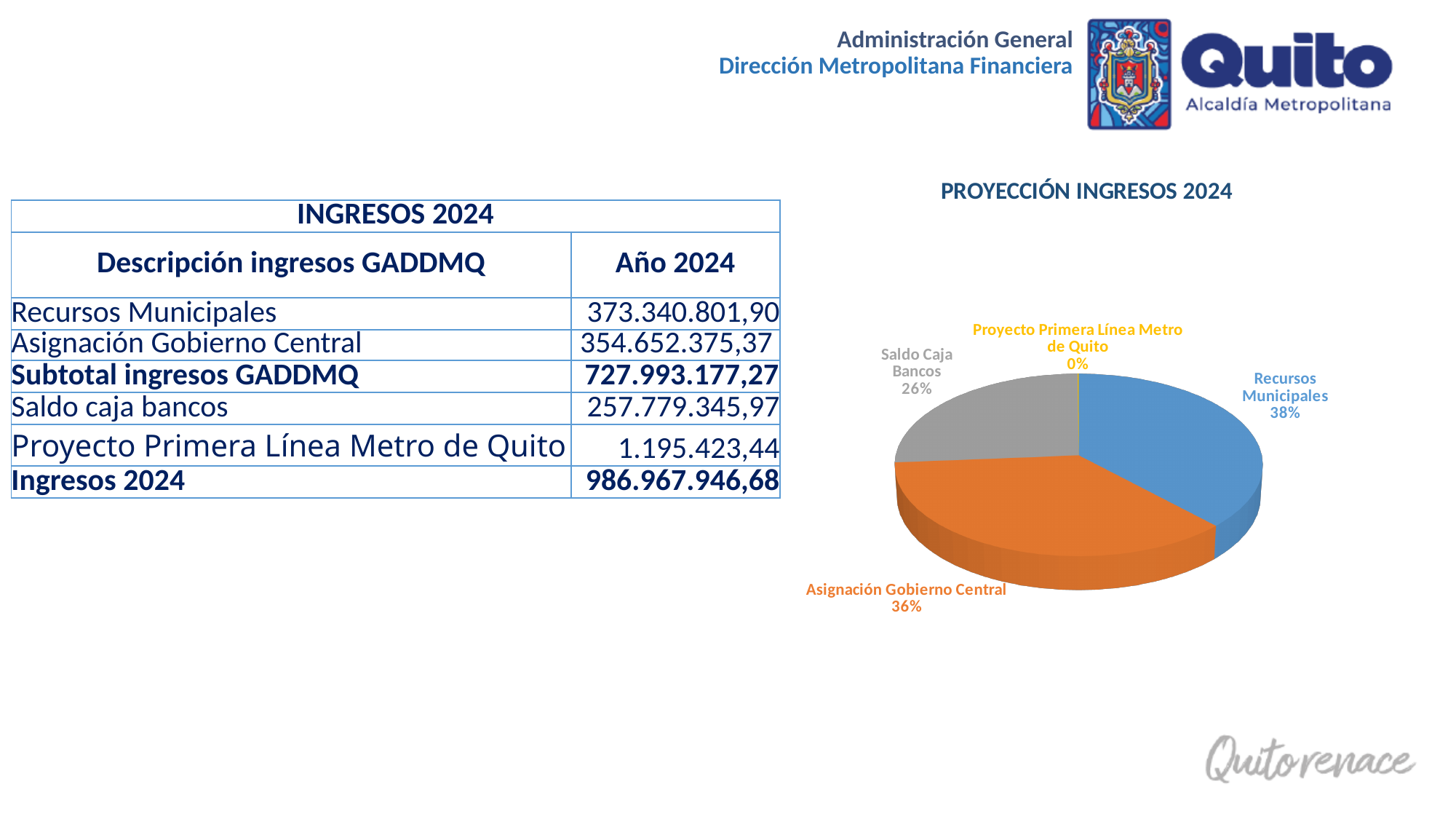
What share of the pie chart does Saldo Caja Bancos represent? 26% What is the title of the pie chart? PROYECCIÓN INGRESOS 2024 What kind of chart is shown under the title PROYECCIÓN INGRESOS 2024? pie chart Which slice of the pie chart is the smallest? Proyecto Primera Línea Metro de Quito How many slices are labelled in the pie chart? 4 What share of the pie chart does Asignación Gobierno Central represent? 36% In the pie chart, what is the difference in percentage points between Recursos Municipales and Saldo Caja Bancos? 12 In the pie chart, which is larger: Asignación Gobierno Central or Saldo Caja Bancos? Asignación Gobierno Central Which slice of the pie chart is the largest? Recursos Municipales What colour is the Asignación Gobierno Central slice in the pie chart? orange What share of the pie chart does Recursos Municipales represent? 38% What percentage is shown for Proyecto Primera Línea Metro de Quito in the pie chart? 0%